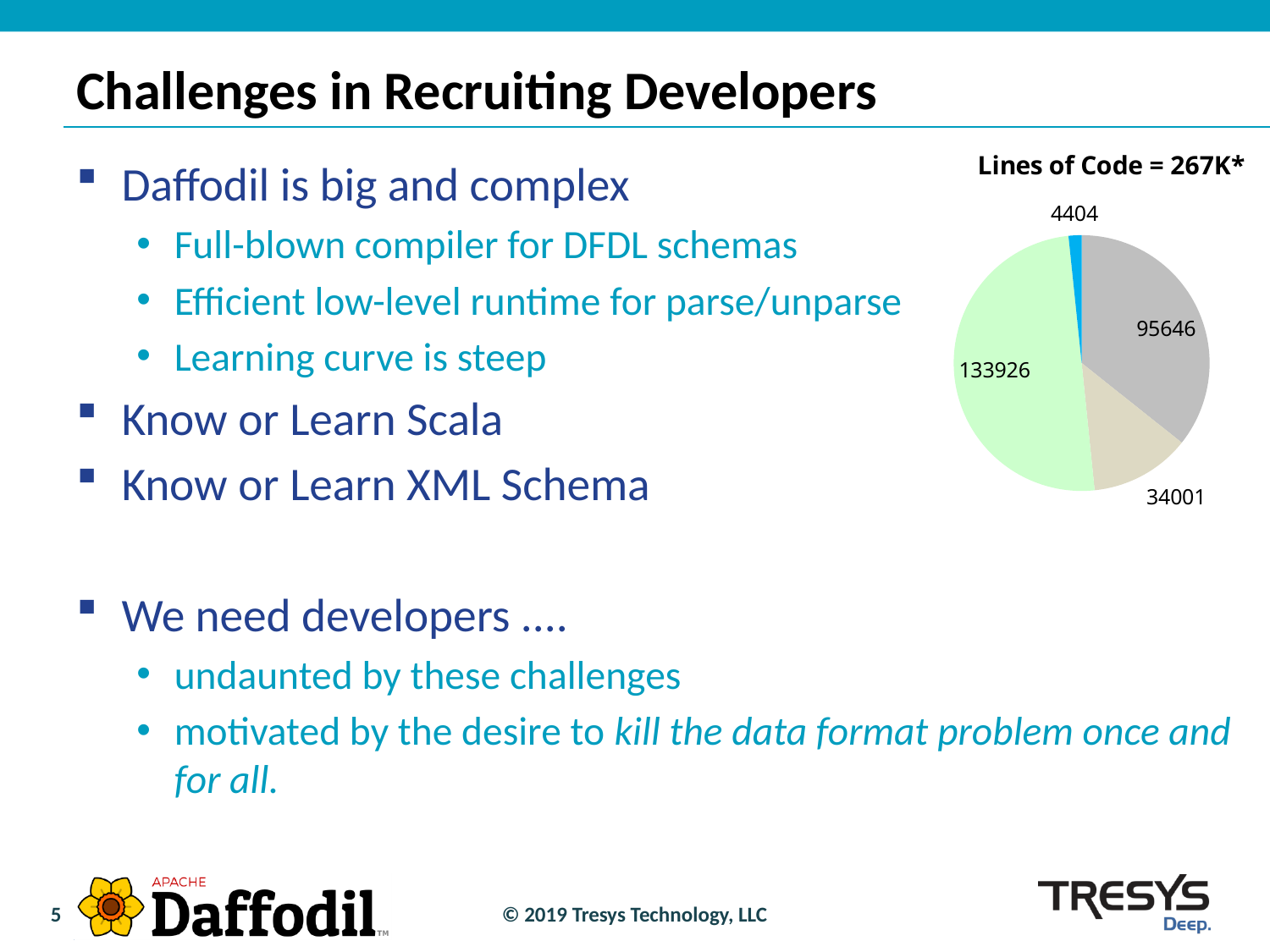
What is the difference between the slice labelled 95646 and the slice labelled 34001? 61645 How many slices does the pie chart have? 4 What is the value of the largest slice in the pie chart? 133926 Which slice is larger, the gray slice or the beige slice? the gray slice (95646) What is the value of the smallest slice in the pie chart? 4404 What value is labelled on the gray slice of the pie chart? 95646 What is the sum of all four slice values shown in the pie chart? 267977 What value is labelled on the beige slice of the pie chart? 34001 What is the difference between the two largest slice values in the pie chart (133926 and 95646)? 38280 What value is labelled on the green slice of the pie chart? 133926 What kind of chart is shown on the slide? pie chart What is the title of the chart on the slide? Lines of Code = 267K*